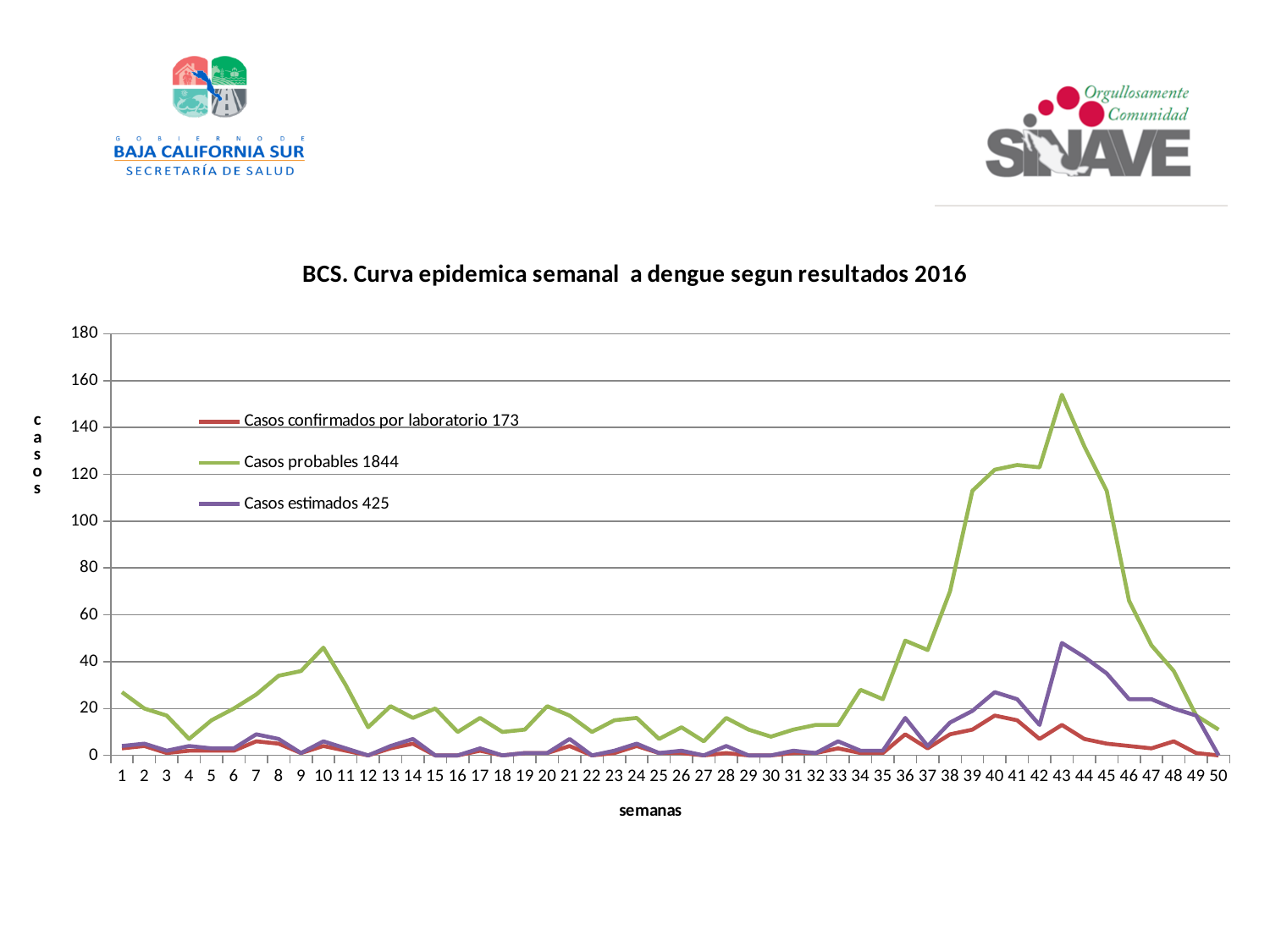
From week 43 to week 50, do the Casos probables values rise or fall? Fall In which week does the Casos probables line reach its highest value? 43 Is the value of Casos estimados in week 43 greater or less than 40? greater Which series reaches the highest value on the chart? Casos probables 1844 How many series does the legend list? 3 How many weeks (semanas) are plotted along the x axis? 50 In week 43, which is higher: Casos probables or Casos estimados? Casos probables What is the title of the chart? BCS. Curva epidemica semanal a dengue segun resultados 2016 Is the value of Casos probables in week 10 greater or less than 40? greater What kind of chart is shown on the slide? Line chart What is the legend label of the green line? Casos probables 1844 Is the value of Casos probables in week 43 greater or less than 140? greater